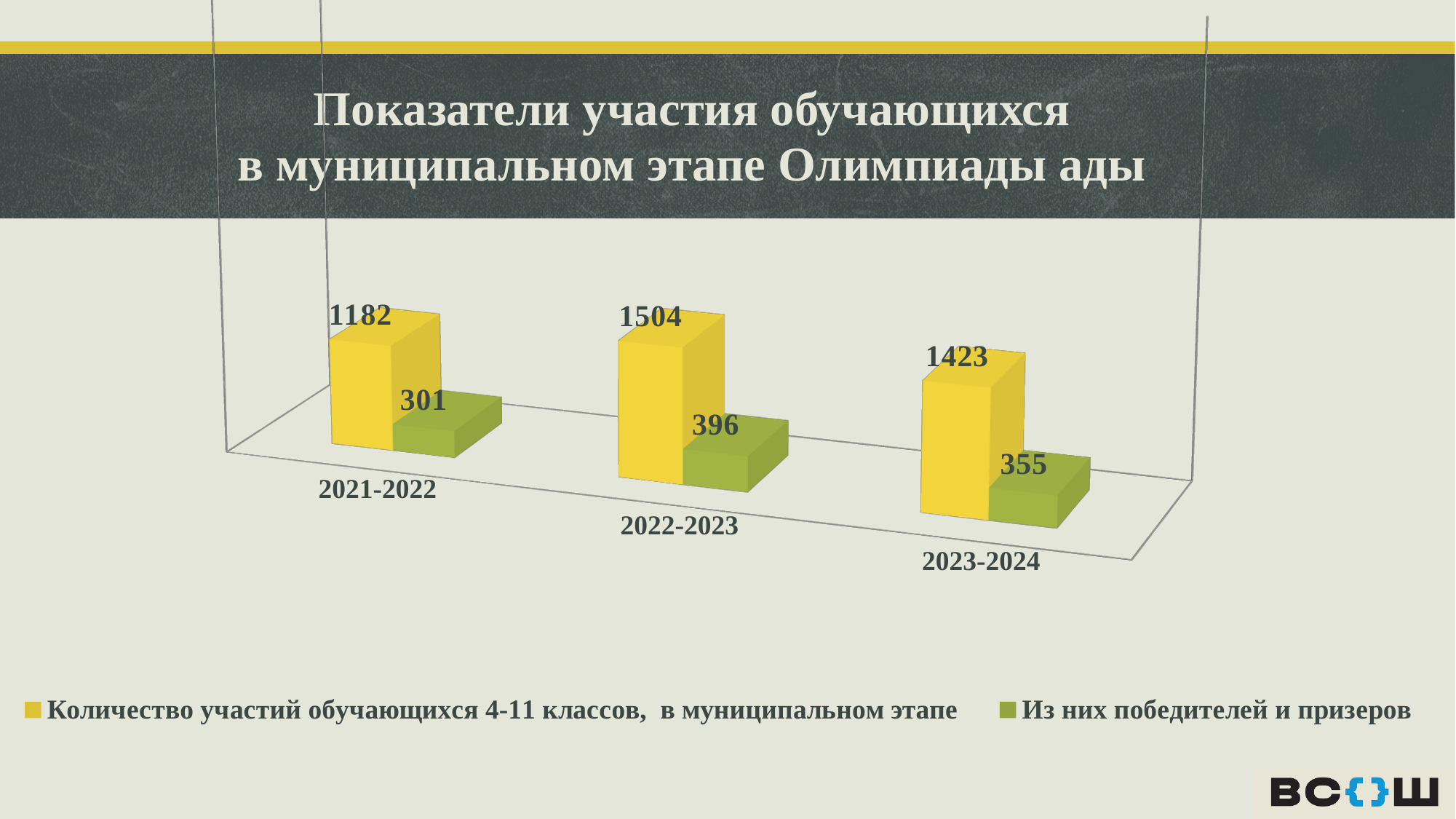
What is the difference between the number of participations in 2022-2023 and in 2021-2022? 322 Which academic year has the lowest number of winners and prize-winners? 2021-2022 How many series does the legend list? 2 How many academic years are shown on the chart? 3 How many winners and prize-winners were there in 2022-2023? 396 Which is larger: the number of participations in 2023-2024 or in 2021-2022? 2023-2024 What kind of chart is shown on the slide? Bar chart What is the difference between the number of winners and prize-winners in 2022-2023 and in 2023-2024? 41 What is the number of participations of students in grades 4-11 in the municipal stage for 2021-2022? 1182 Which academic year has the highest number of participations in the municipal stage? 2022-2023 Which colour represents the series 'Из них победителей и призеров'? Green What is the number of participations in the municipal stage for 2023-2024? 1423